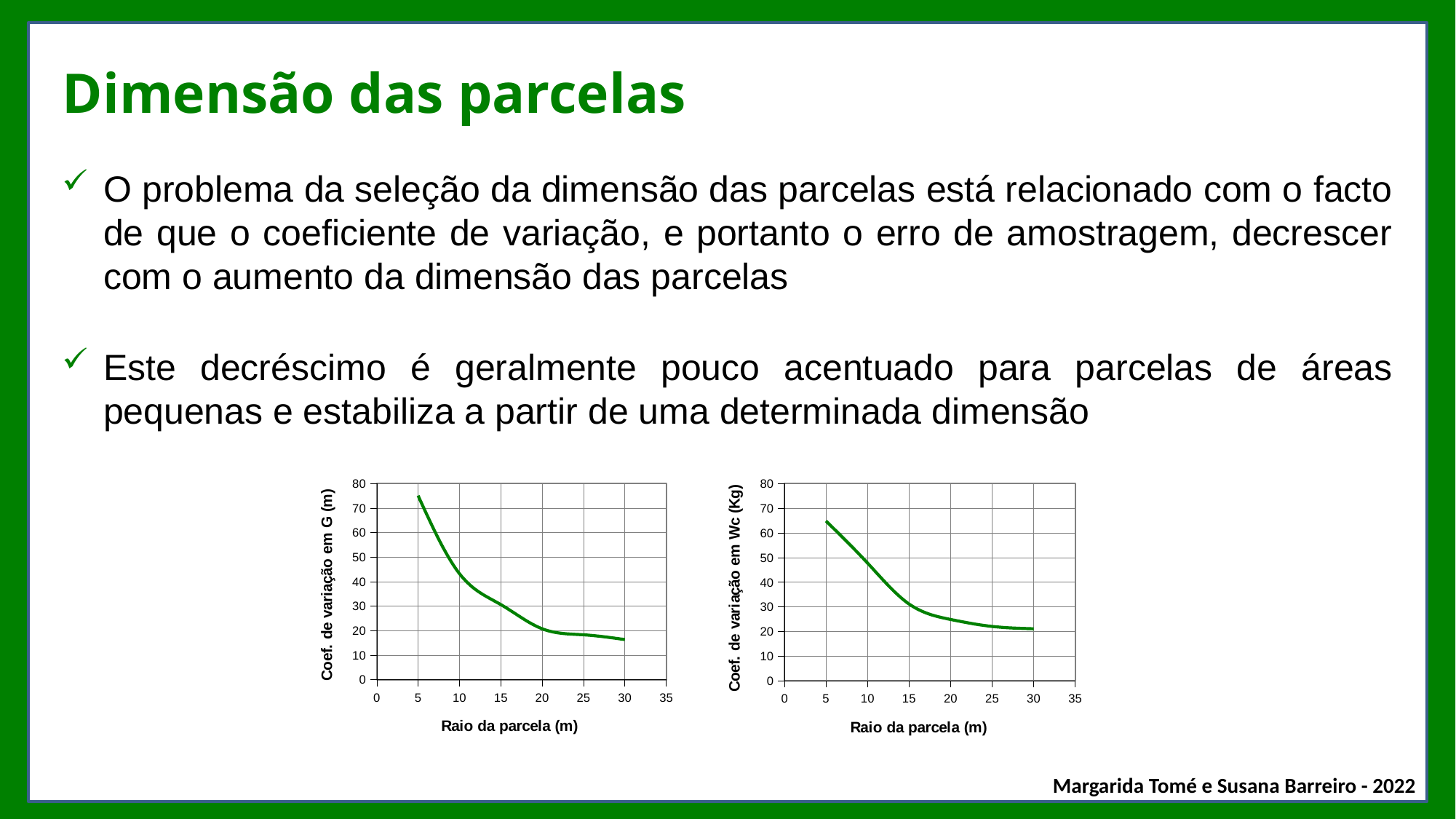
In the right chart, is the value at a plot radius of 5 m greater or less than 60? greater In the left chart, is the value at a plot radius of 10 m greater or less than 30? greater In the left chart, do the values rise or fall as the plot radius increases? fall What is the label of the x axis on the left chart? Raio da parcela (m) What is the label of the y axis on the right chart? Coef. de variação em Wc (Kg) What kind of chart is the left chart on the slide? line chart In the right chart, is the value at a plot radius of 30 m greater or less than 30? less In the right chart, do the values rise or fall as the plot radius increases? fall What kind of chart is the right chart on the slide? line chart